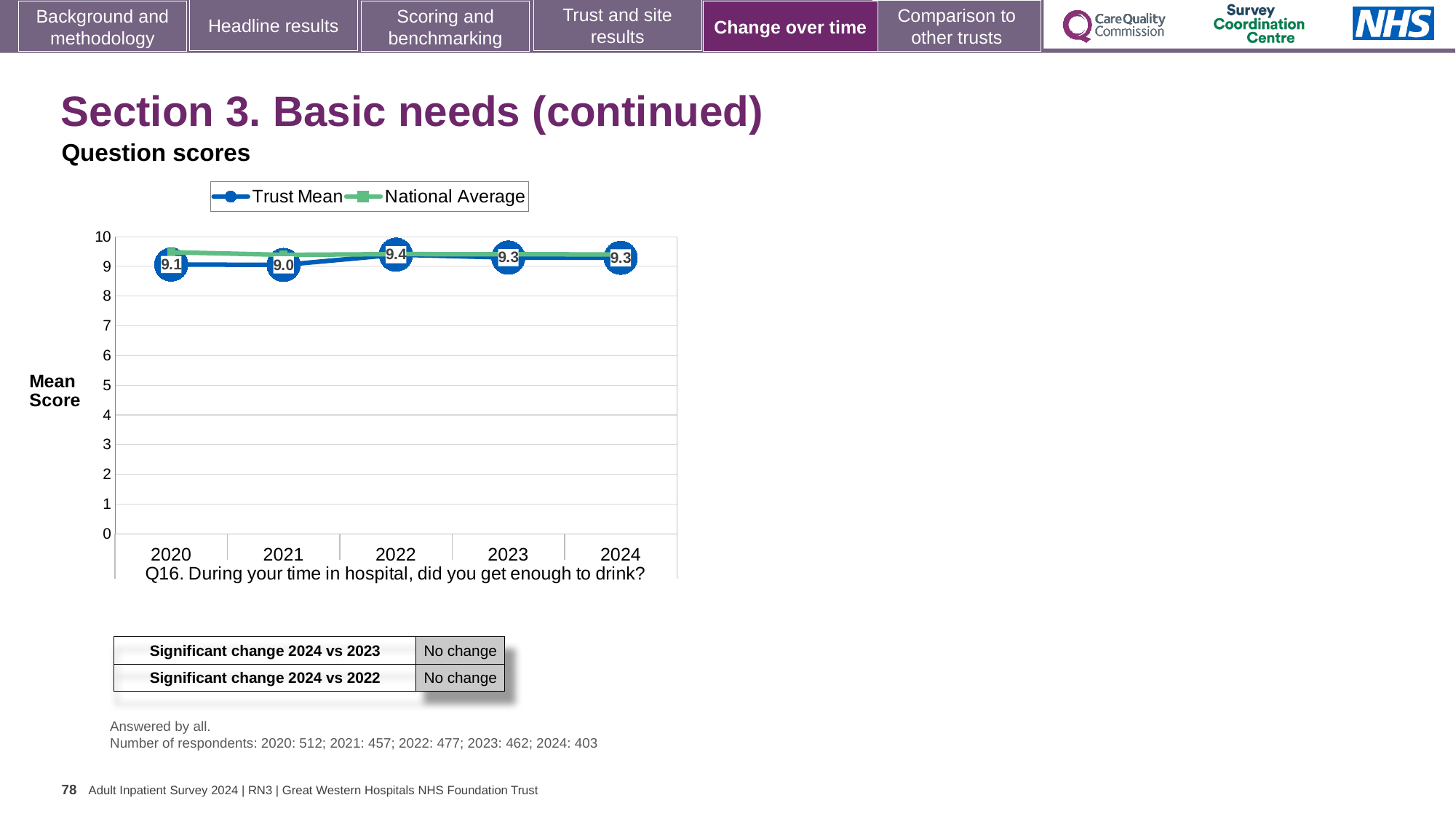
What is the difference between the Trust Mean scores for 2022 and 2021? 0.4 What kind of chart is shown on the slide? line chart Which year has the larger Trust Mean score, 2020 or 2021? 2020 In which year is the Trust Mean score lowest? 2021 What is the Trust Mean score for 2021? 9.0 Does the Trust Mean score rise or fall from 2021 to 2022? rise How many years are plotted on the x axis? 5 In which year is the Trust Mean score highest? 2022 What is the Trust Mean score for 2024? 9.3 What is the Trust Mean score for 2022? 9.4 How many series does the legend list? 2 Is the National Average value for 2020 greater or less than 8? greater